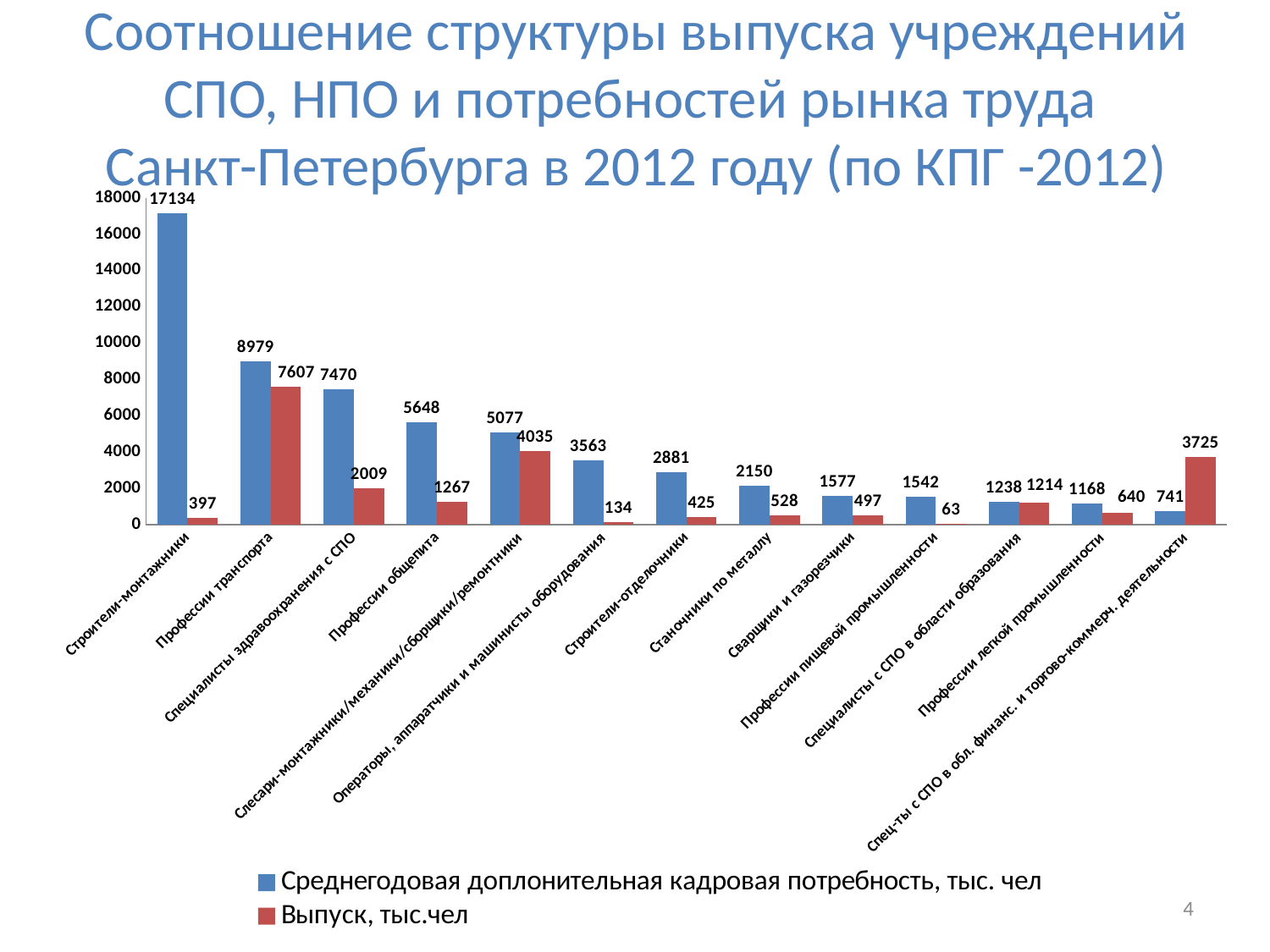
What is the value of "Выпуск, тыс.чел" for Профессии транспорта? 7607 What colour are the bars for "Выпуск, тыс.чел"? red Which category has the lowest value of "Среднегодовая доплонительная кадровая потребность, тыс. чел"? Спец-ты с СПО в обл. финанс. и торгово-коммерч. деятельности For Спец-ты с СПО в обл. финанс. и торгово-коммерч. деятельности, which series has the larger value? Выпуск, тыс.чел Which category has the highest value of "Выпуск, тыс.чел"? Профессии транспорта What is the difference between the two series values for Строители-монтажники? 16737 What is the value of "Выпуск, тыс.чел" for Профессии пищевой промышленности? 63 What kind of chart is shown on the slide? bar chart Is the value of "Среднегодовая доплонительная кадровая потребность, тыс. чел" for Профессии общепита greater or less than 4000? greater How many categories are shown on the x axis? 13 What is the value of "Среднегодовая доплонительная кадровая потребность, тыс. чел" for Строители-монтажники? 17134 How many series does the legend list? 2